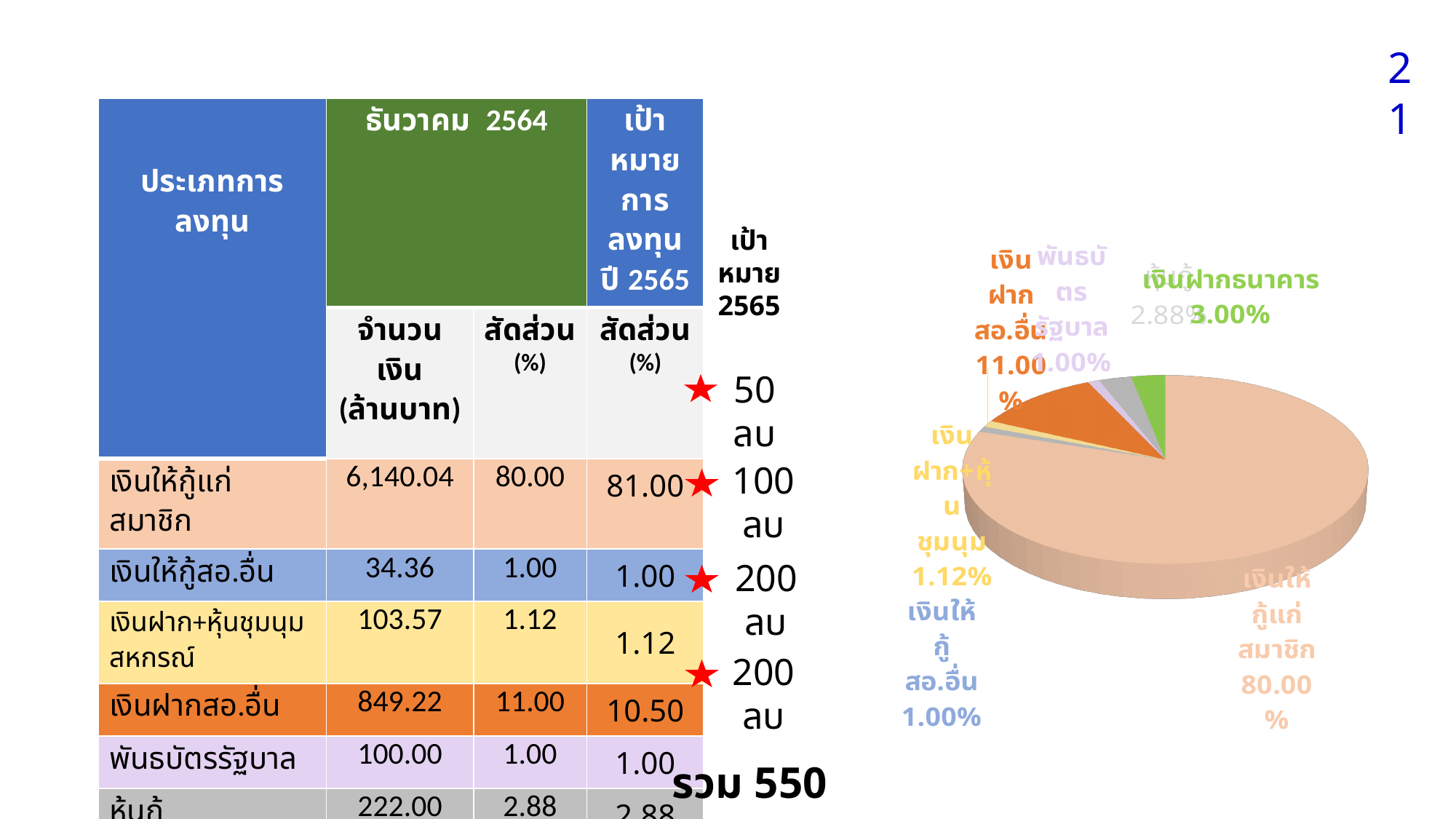
What kind of chart is shown on the right side of the slide? pie chart In the pie chart, which is larger: เงินฝากสอ.อื่น or เงินฝากธนาคาร? เงินฝากสอ.อื่น In the pie chart, what colour is the largest slice? peach (light orange) In the pie chart, how many slices are there? 7 In the pie chart, what percentage is shown for เงินฝากธนาคาร? 3.00% In the pie chart, what percentage is shown for เงินฝากสอ.อื่น? 11.00% In the pie chart, which is smaller: เงินฝาก+หุ้นชุมนุมสหกรณ์ or เงินฝากธนาคาร? เงินฝาก+หุ้นชุมนุมสหกรณ์ In the pie chart, what percentage is shown for เงินฝาก+หุ้นชุมนุมสหกรณ์? 1.12% In the pie chart, which category has the largest slice? เงินให้กู้แก่สมาชิก In the pie chart, what percentage is shown for เงินให้กู้แก่สมาชิก? 80.00% In the pie chart, what is the difference between the percentages for เงินให้กู้แก่สมาชิก and เงินฝากสอ.อื่น? 69.00% In the pie chart, what percentage is shown for เงินให้กู้สอ.อื่น? 1.00%